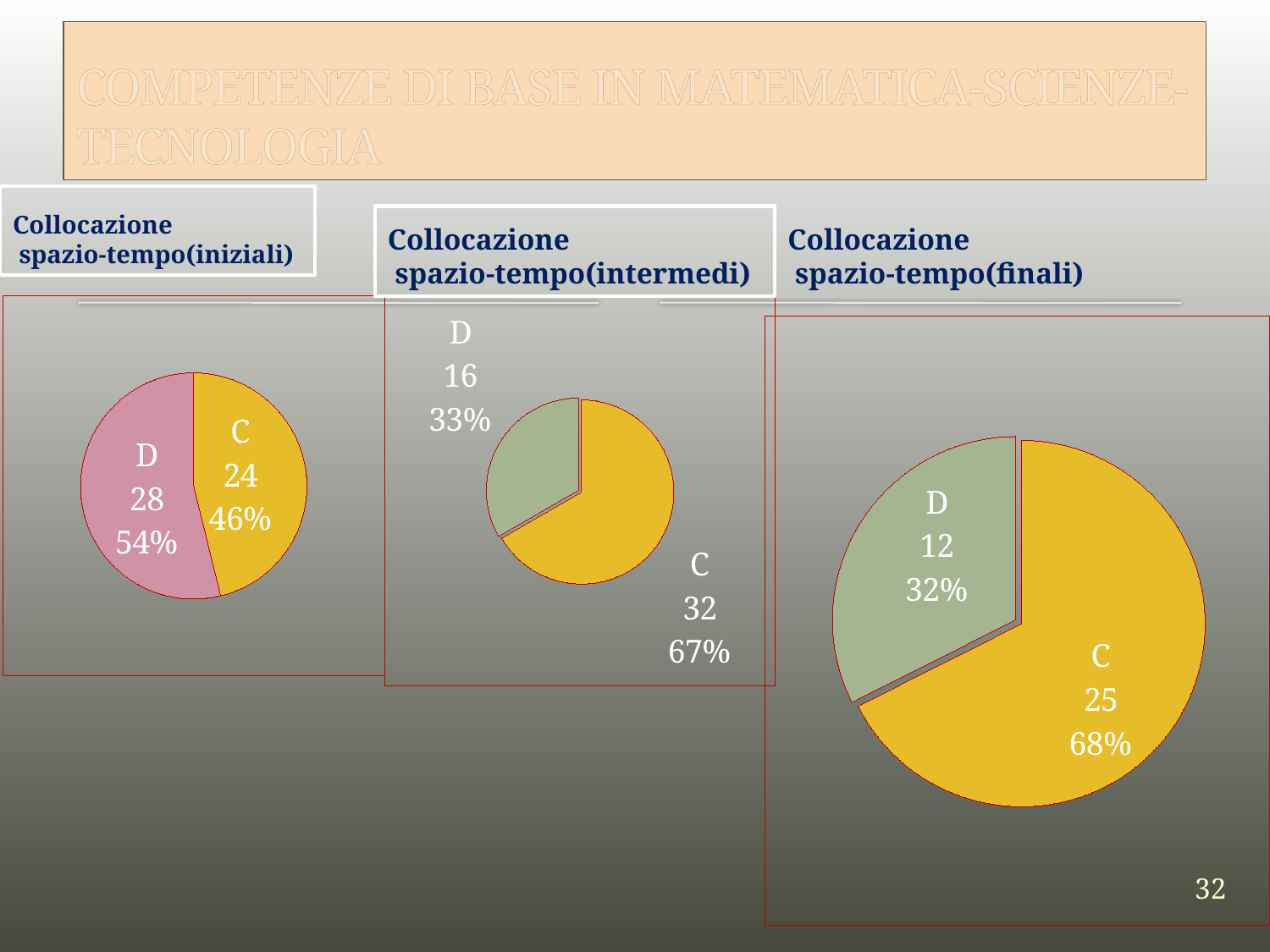
How many slices does the 'Collocazione spazio-tempo(iniziali)' pie chart have? 2 In the 'Collocazione spazio-tempo(iniziali)' pie chart, which category is the largest? D In the 'Collocazione spazio-tempo(iniziali)' pie chart, what is the value for D? 28 In the 'Collocazione spazio-tempo(finali)' pie chart, which is larger, C or D? C In the 'Collocazione spazio-tempo(iniziali)' pie chart, what percentage share does C have? 46% In the 'Collocazione spazio-tempo(intermedi)' pie chart, what is the value for C? 32 In the 'Collocazione spazio-tempo(finali)' pie chart, which category is the smallest? D In the 'Collocazione spazio-tempo(finali)' pie chart, what is the value for D? 12 What type of chart is used for 'Collocazione spazio-tempo(finali)'? Pie chart In the 'Collocazione spazio-tempo(intermedi)' pie chart, what percentage share does D have? 33% In the 'Collocazione spazio-tempo(finali)' pie chart, what percentage share does C have? 68% In the 'Collocazione spazio-tempo(intermedi)' pie chart, what is the difference between the values for C and D? 16